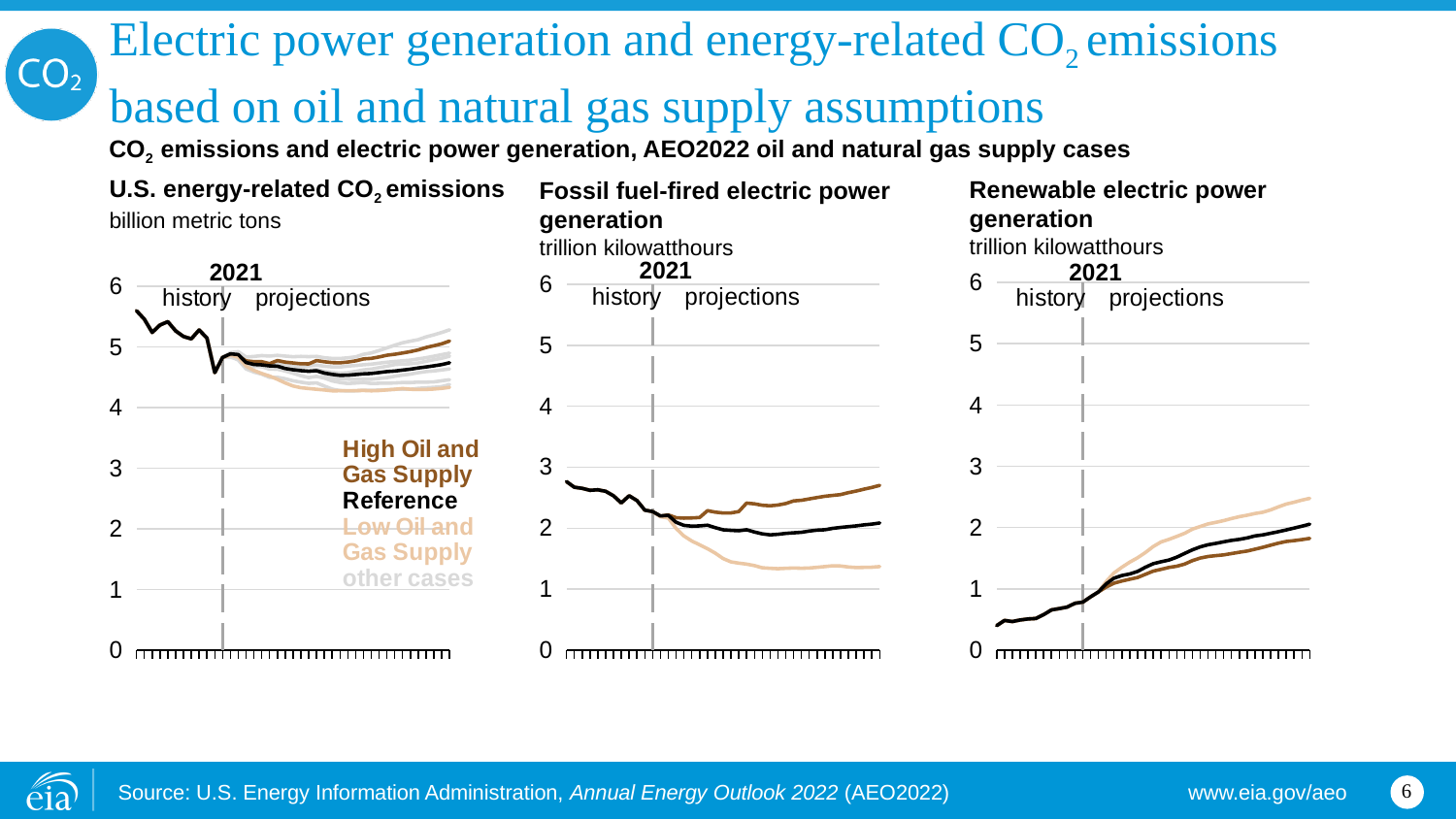
In the 'Fossil fuel-fired electric power generation' chart, is the High Oil and Gas Supply value at the end of the projection period greater or less than 2? greater In the 'U.S. energy-related CO2 emissions' chart, what unit is shown on the y axis? billion metric tons In the 'U.S. energy-related CO2 emissions' chart, is the Low Oil and Gas Supply value at the end of the projection period greater or less than 5? less In the 'U.S. energy-related CO2 emissions' chart, is the Reference case value at the end of the projection period greater or less than 4? greater In the 'Fossil fuel-fired electric power generation' chart, which case is highest at the end of the projection period? High Oil and Gas Supply In the 'Fossil fuel-fired electric power generation' chart, does the Low Oil and Gas Supply line rise or fall over the projection period? fall In the 'Renewable electric power generation' chart, what unit is shown on the y axis? trillion kilowatthours In the 'Renewable electric power generation' chart, do the values rise or fall over the projection period? rise In the 'Renewable electric power generation' chart, which case is highest at the end of the projection period? Low Oil and Gas Supply What kind of chart is the 'U.S. energy-related CO2 emissions' chart? line chart